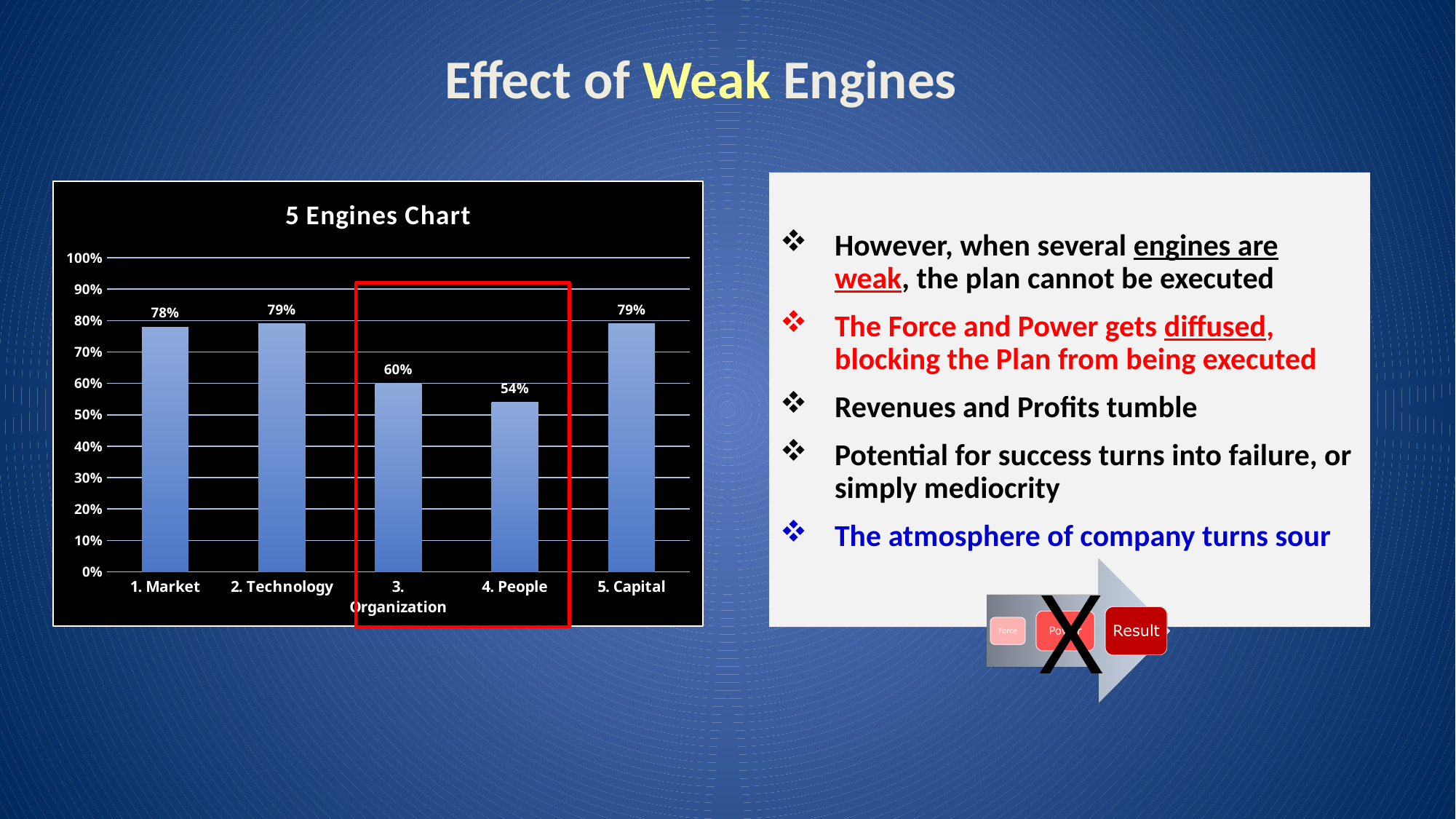
What is the difference between the values for 2. Technology and 4. People? 25% Which is larger, the value for 1. Market or the value for 3. Organization? 1. Market Which category has the lowest value? 4. People What is the value for 1. Market? 78% Is the value for 4. People greater or less than 60%? less What kind of chart is shown on the slide? bar chart How many categories are shown in the chart? 5 What is the value for 3. Organization? 60% What is the value for 4. People? 54% What is the difference between the values for 3. Organization and 4. People? 6% What is the title of the chart? 5 Engines Chart What is the value for 5. Capital? 79%